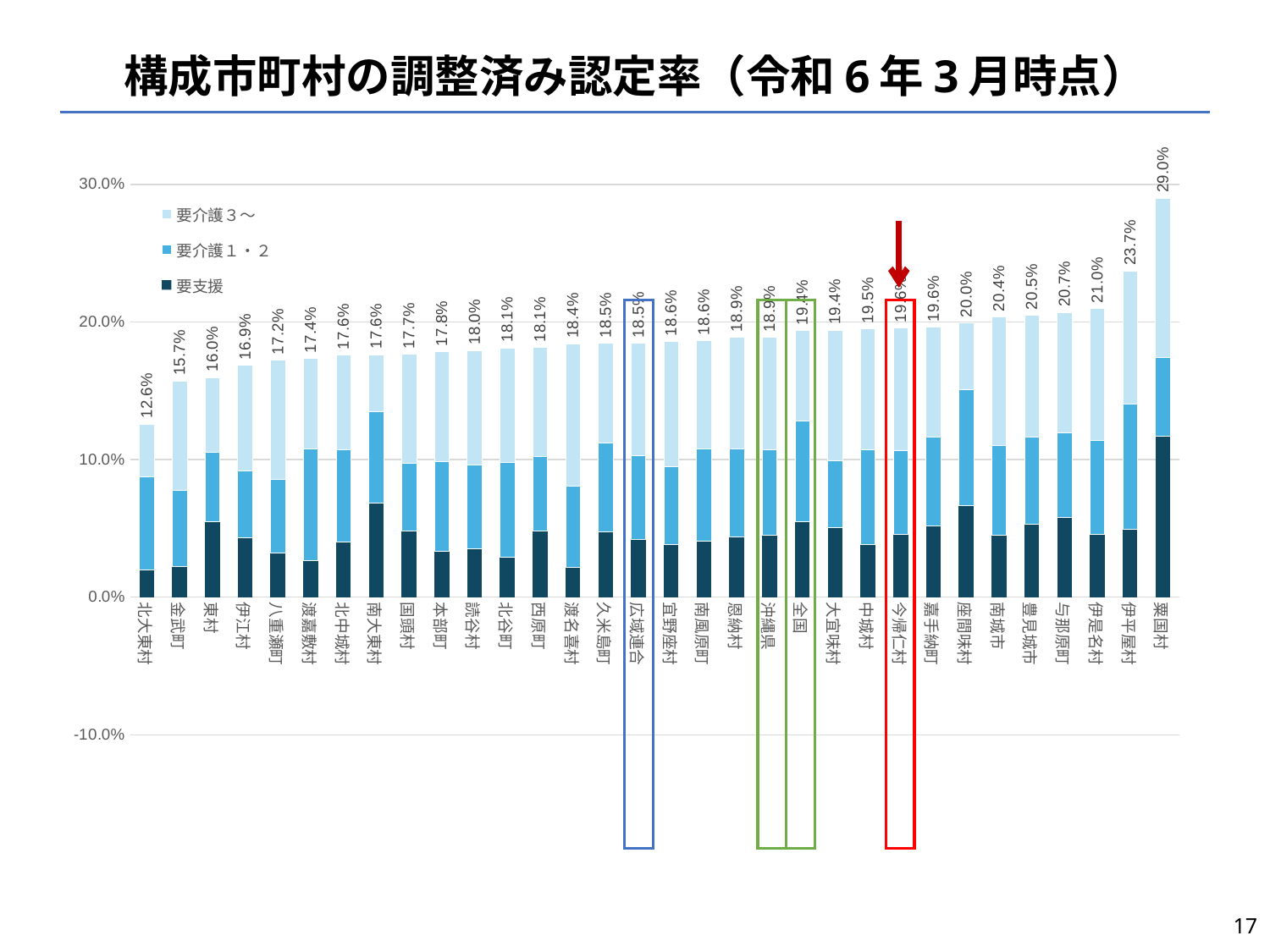
Do the total values rise or fall from left to right along the x axis? Rise What is the difference between the total values for 粟国村 and 伊平屋村? 5.3 percentage points Which has the larger total value, 全国 or 沖縄県? 全国 What kind of chart is shown on the slide? Stacked bar chart How many series does the legend list? 3 What is the total value shown for 全国? 19.4% Which category has the lowest total adjusted certification rate? 北大東村 What is the total value shown for 沖縄県? 18.9% Is the 要支援 segment for 粟国村 greater or less than 10.0%? greater Which category has the highest total adjusted certification rate? 粟国村 How many categories are plotted on the x axis? 32 What is the total value shown for 広域連合? 18.5%